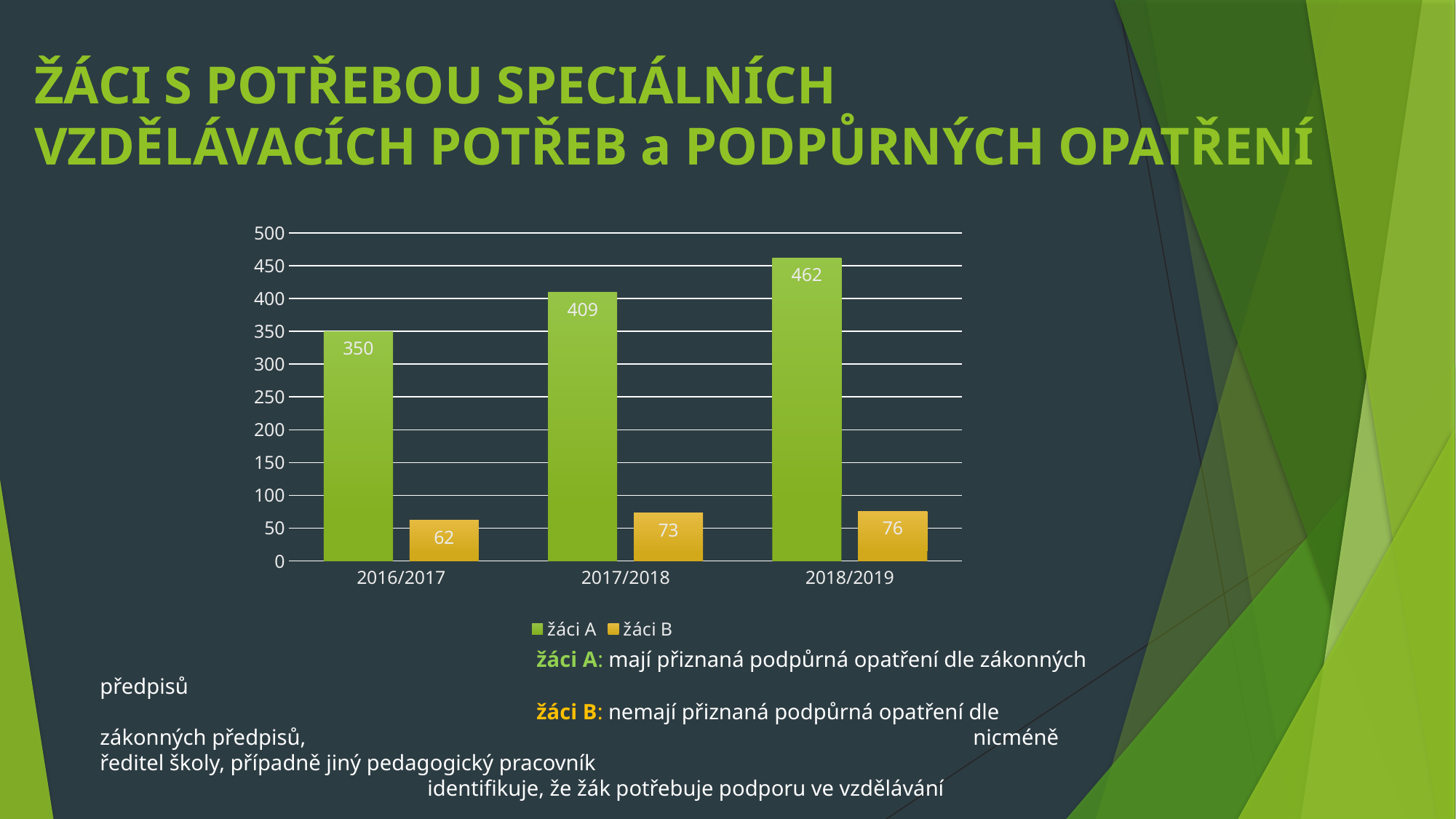
What is the value for žáci B in 2016/2017? 62 In which school year is the value for žáci B lowest? 2016/2017 In which school year is the value for žáci A highest? 2018/2019 Which is larger: žáci B in 2018/2019 or žáci B in 2017/2018? žáci B in 2018/2019 What is the difference between žáci A in 2018/2019 and žáci A in 2017/2018? 53 How many series does the legend list? 2 What is the value for žáci B in 2017/2018? 73 How many school years are shown on the x axis? 3 What kind of chart is shown on the slide? bar chart What is the value for žáci A in 2018/2019? 462 Do the values for žáci A rise or fall from 2016/2017 to 2018/2019? rise What is the value for žáci A in 2016/2017? 350